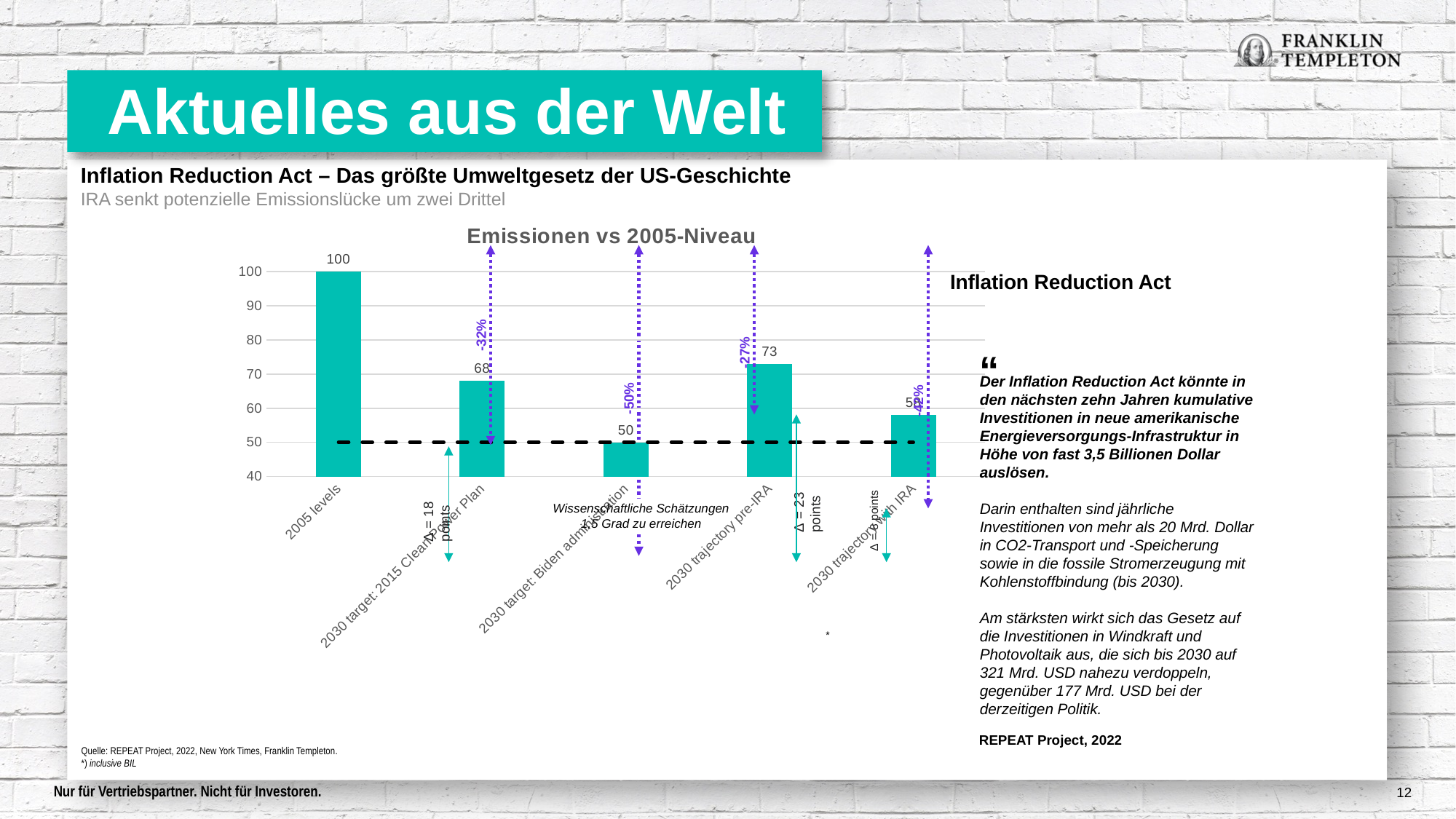
What is the value for 2005 levels? 100 What is the value for 2030 trajectory pre-IRA? 73 What is the value for 2030 target: Biden administration? 50 What is the difference between the values for 2030 trajectory pre-IRA and 2030 target: 2015 Clean Power Plan? 5 What is the title of the chart? Emissionen vs 2005-Niveau Which category has the lowest value? 2030 target: Biden administration Is the value for 2030 trajectory with IRA greater or less than 50? greater What is the value for 2030 target: 2015 Clean Power Plan? 68 How many categories are shown on the x axis of the chart? 5 Which category has the highest value? 2005 levels What type of chart is shown on the slide? bar and line chart Which is larger, the value for 2030 target: 2015 Clean Power Plan or the value for 2030 trajectory pre-IRA? 2030 trajectory pre-IRA